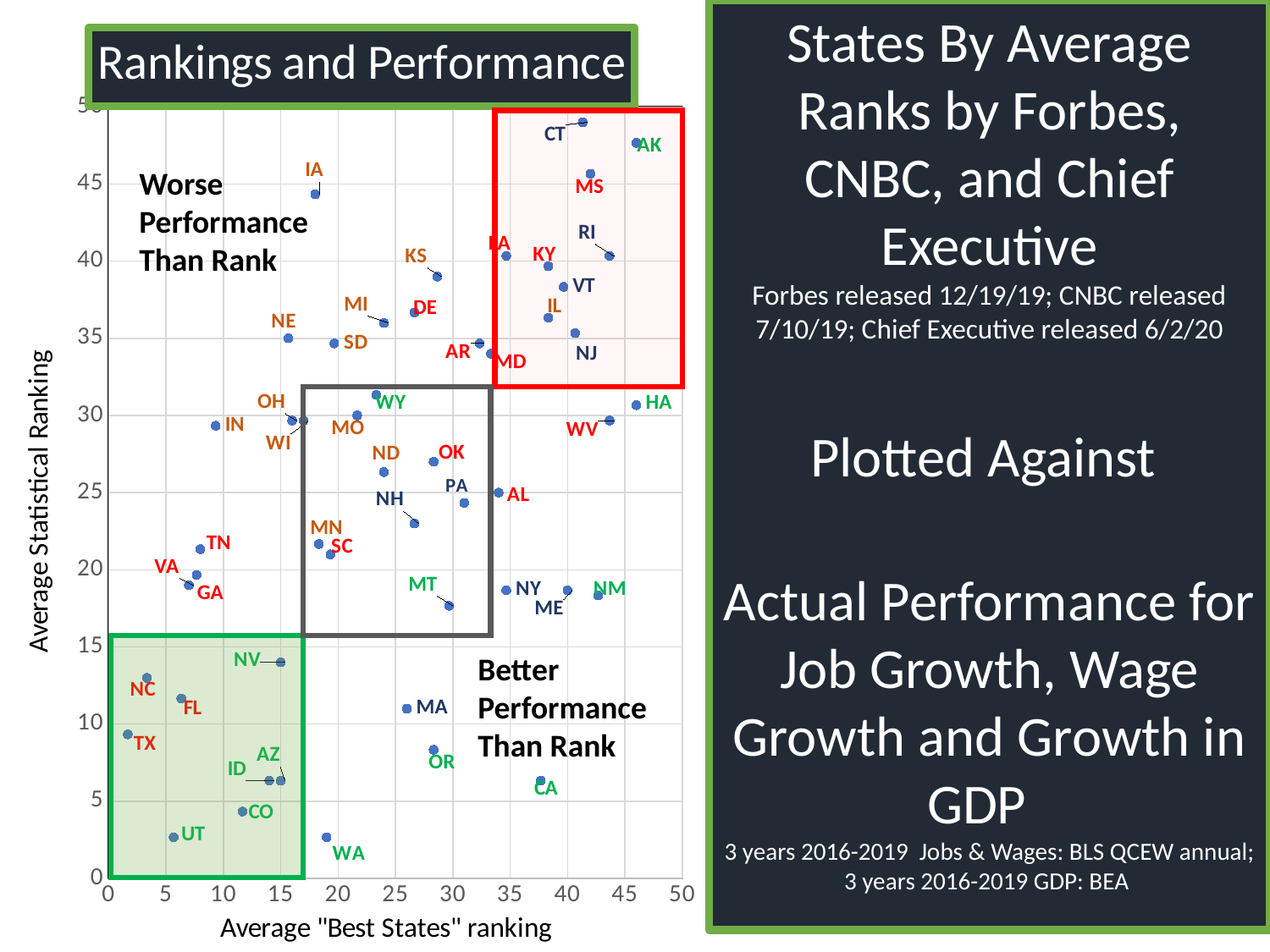
Is the Average Statistical Ranking for MA greater or less than 15? less Is the Average Statistical Ranking for KS greater or less than 35? greater Is the Average Statistical Ranking for WA greater or less than 5? less What is the label of the x axis of the chart? Average "Best States" ranking What kind of chart is shown on the slide? scatter plot Which state has a higher Average Statistical Ranking, CT or WA? CT Which state has the highest Average Statistical Ranking on the chart? CT What is the title of the chart? Rankings and Performance